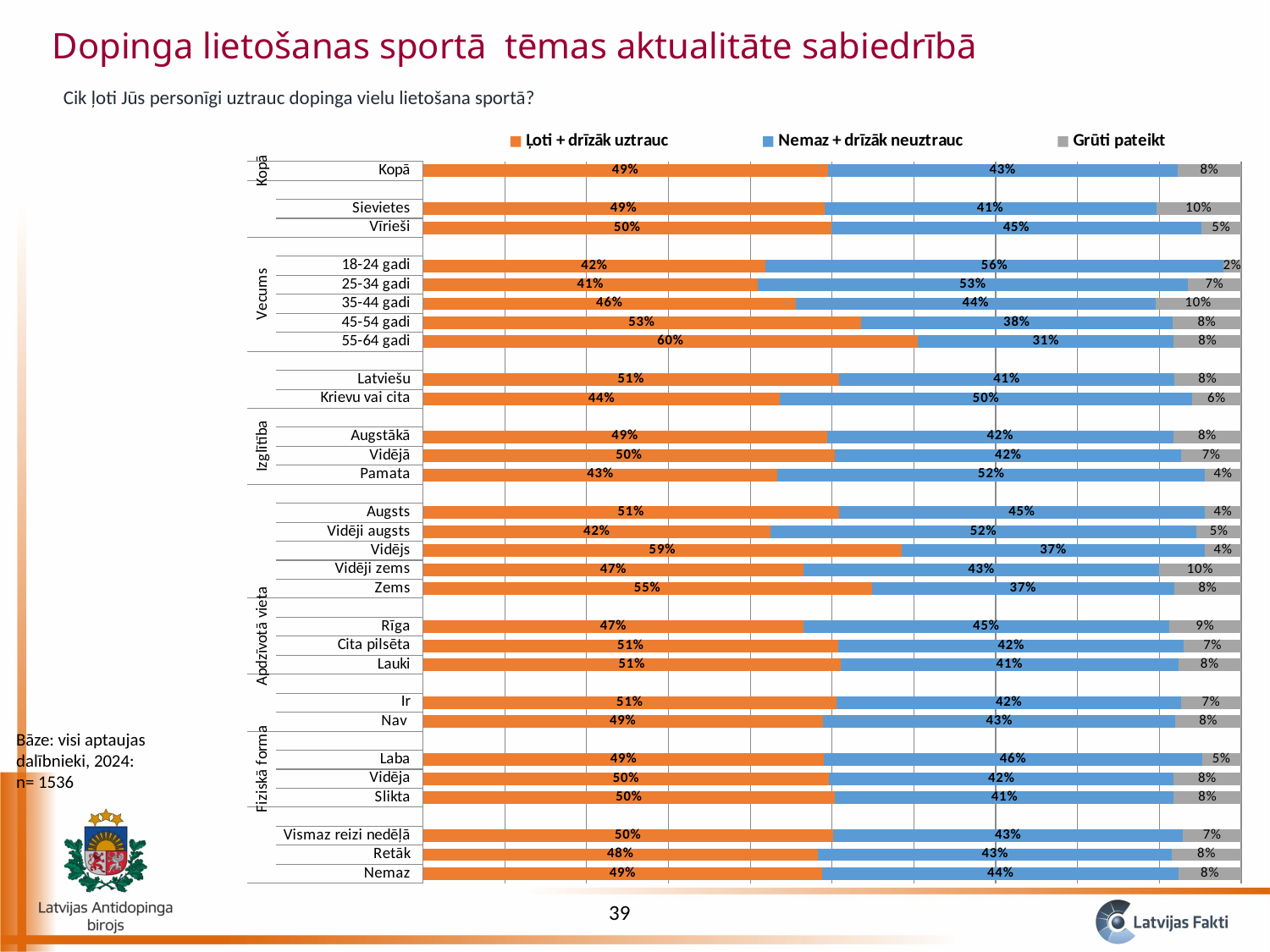
What is the value of "Ļoti + drīzāk uztrauc" for the category "Kopā"? 49% Which category has the highest value for "Ļoti + drīzāk uztrauc"? 55-64 gadi What is the total of the three segments for the "Vidējs" bar? 100% Which category has the lowest value for "Grūti pateikt"? 18-24 gadi What kind of chart is shown on the slide? Stacked bar chart What is the difference between the "Ļoti + drīzāk uztrauc" values for "55-64 gadi" and "18-24 gadi"? 18 percentage points What is the value of "Nemaz + drīzāk neuztrauc" for "18-24 gadi"? 56% What is the value of "Grūti pateikt" for "Sievietes"? 10% What is the value of "Ļoti + drīzāk uztrauc" for "Rīga"? 47% How many series does the legend list? 3 Which legend entry is shown in orange? Ļoti + drīzāk uztrauc Which has a larger "Nemaz + drīzāk neuztrauc" value: "Latviešu" or "Krievu vai cita"? Krievu vai cita